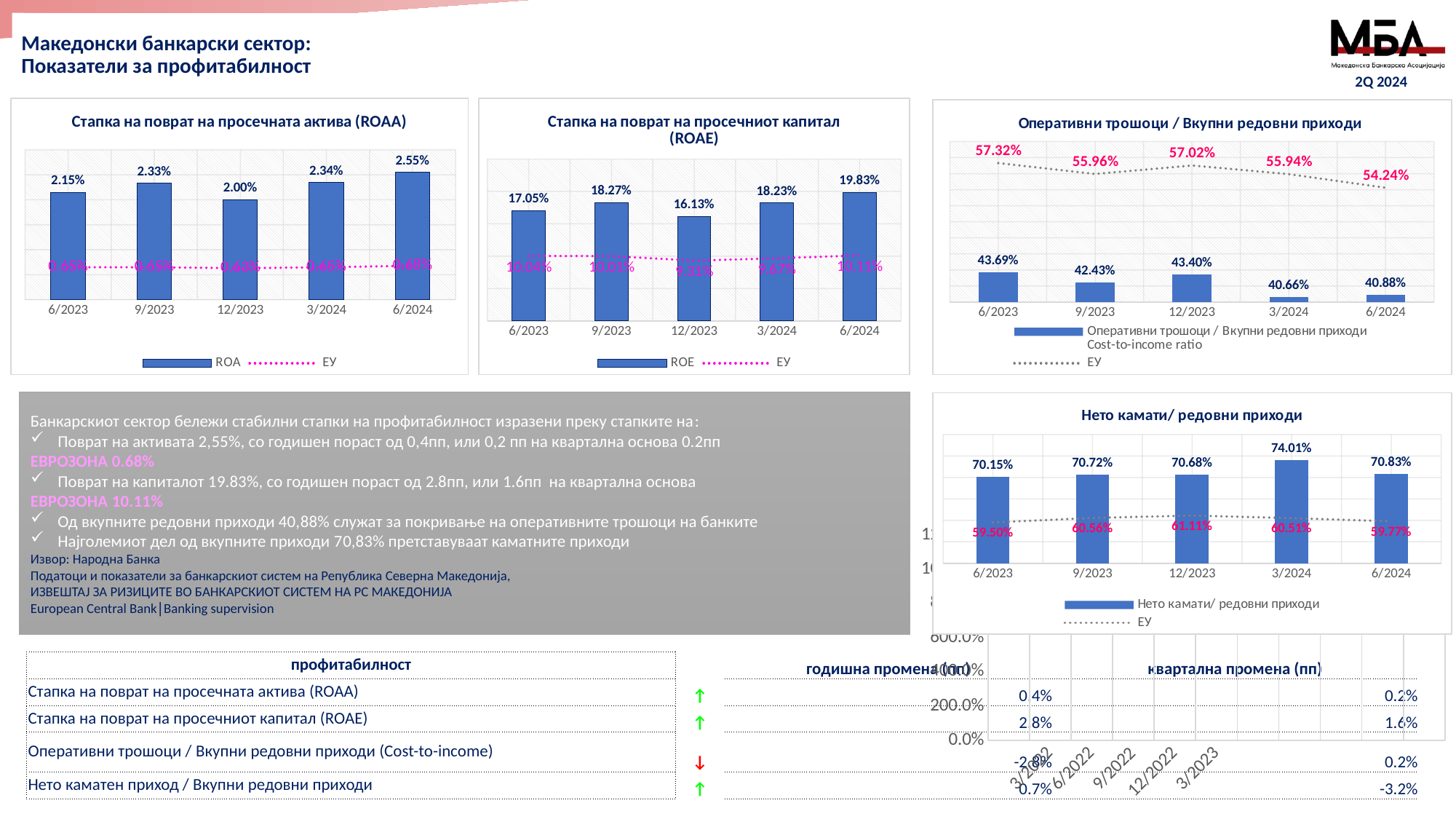
In the ROAA chart (Стапка на поврат на просечната актива), what is the ROA value for 6/2024? 2.55% In the ROAE chart, which period has the highest ROE value? 6/2024 In the chart titled 'Оперативни трошоци / Вкупни редовни приходи', what is the ЕУ value for 6/2023? 57.32% In the ROAA chart, which period has the lowest ROA value? 12/2023 In the chart titled 'Оперативни трошоци / Вкупни редовни приходи', is the bar value for 9/2023 larger or smaller than the bar value for 12/2023? smaller In the ROAA chart, what is the difference between the ROA values for 6/2024 and 6/2023? 0.40% In the chart titled 'Нето камати/ редовни приходи', what is the ЕУ value for 12/2023? 61.11% In the chart titled 'Нето камати/ редовни приходи', which period has the highest bar value? 3/2024 In the ROAE chart, what is the ЕУ value for 6/2024? 10.11% In the ROAE chart (Стапка на поврат на просечниот капитал), what is the ROE value for 12/2023? 16.13% How many periods are shown on the x axis of the ROAA chart? 5 In the chart titled 'Оперативни трошоци / Вкупни редовни приходи', what is the bar value for 3/2024? 40.66%